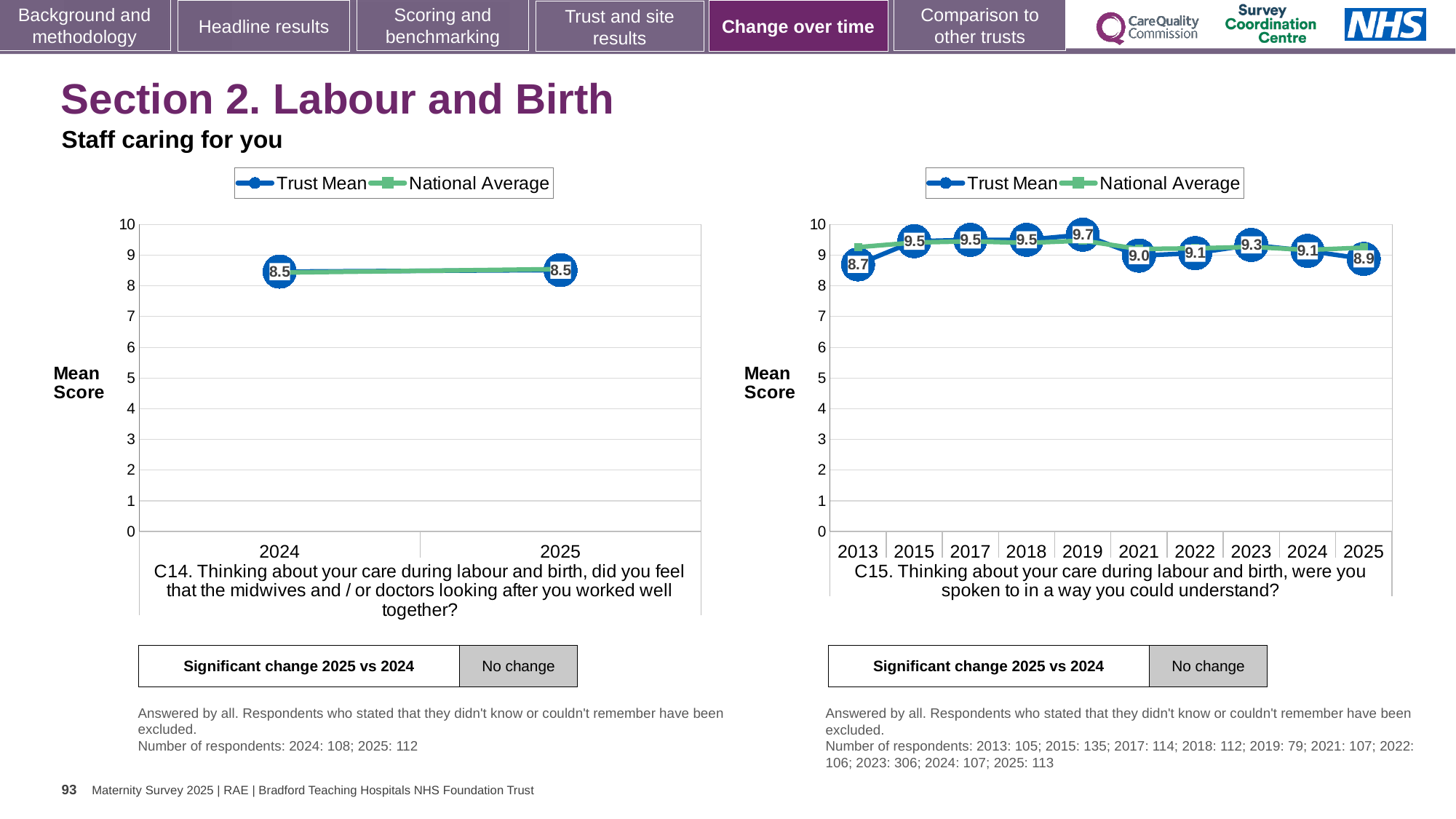
How many series does the legend of the C14 chart on the left list? 2 In the C15 chart on the right, is the Trust Mean higher in 2023 or in 2025? 2023 In the C15 chart on the right, does the Trust Mean rise or fall from 2019 to 2021? Fall In the C15 chart on the right, what is the difference between the Trust Mean in 2019 and in 2013? 1.0 In the C15 chart on the right, what is the Trust Mean for 2019? 9.7 In the C15 chart on the right, what is the Trust Mean for 2013? 8.7 In the C15 chart on the right, which year has the highest Trust Mean? 2019 In the C15 chart on the right, which year has the lowest Trust Mean? 2013 In the C15 chart on the right, is the Trust Mean for 2021 greater or less than 8? greater What type of chart is the C15 chart on the right? Line chart In the C14 chart on the left, what is the Trust Mean for 2025? 8.5 How many years are plotted on the x axis of the C15 chart on the right? 10